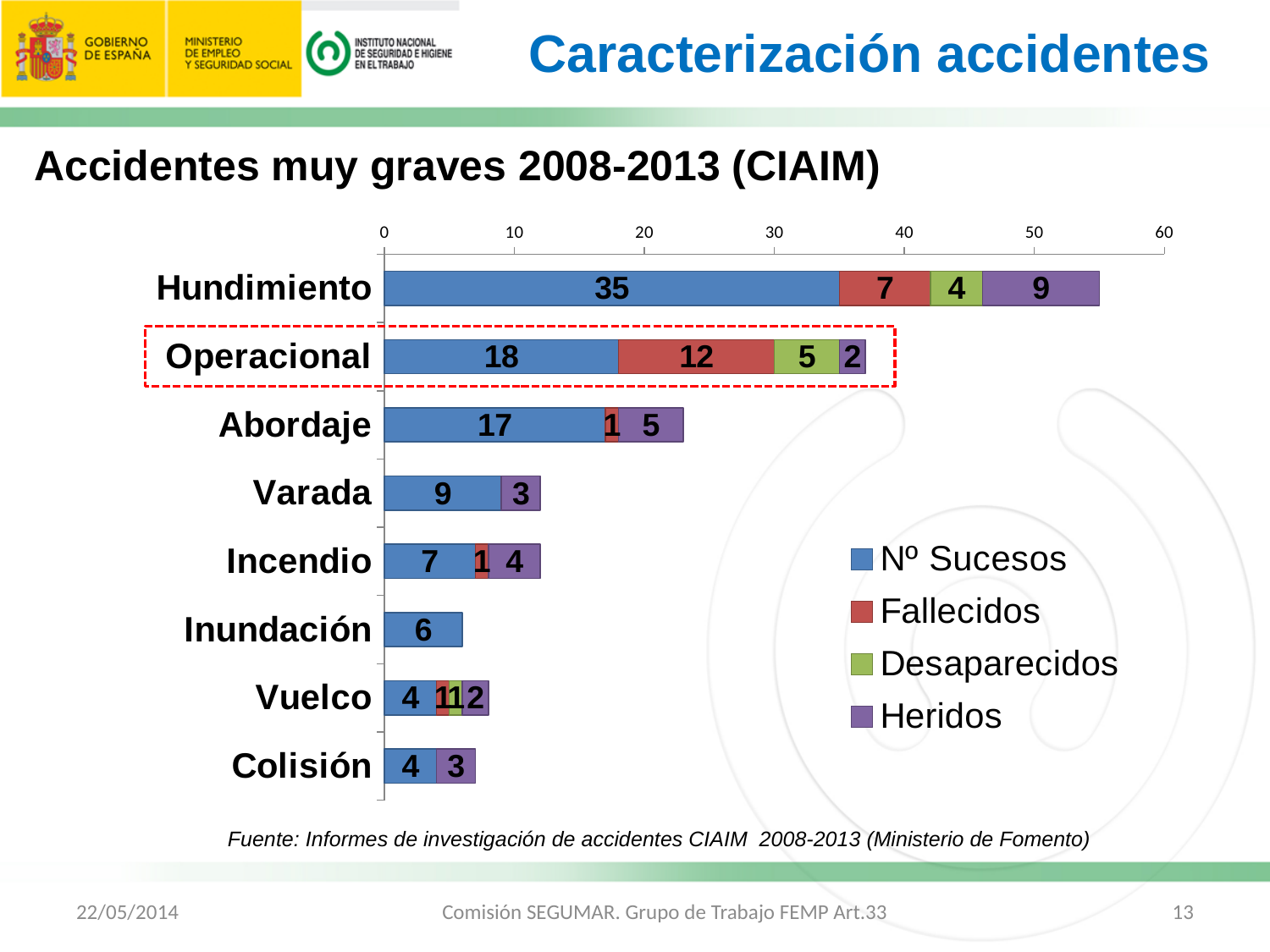
What is the Nº Sucesos value for Hundimiento? 35 Which category has the highest Nº Sucesos value? Hundimiento What is the Heridos value for Abordaje? 5 What is the difference between the Nº Sucesos values for Hundimiento and Operacional? 17 How many accident categories are shown on the chart? 8 What is the total of the stacked bar for Operacional? 37 Which category has the highest Fallecidos value? Operacional Which is larger, the Heridos value for Hundimiento or the Heridos value for Varada? Hundimiento What is the title of the chart? Accidentes muy graves 2008-2013 (CIAIM) What is the Fallecidos value for Operacional? 12 What kind of chart is shown on the slide? stacked bar chart How many series does the legend list? 4